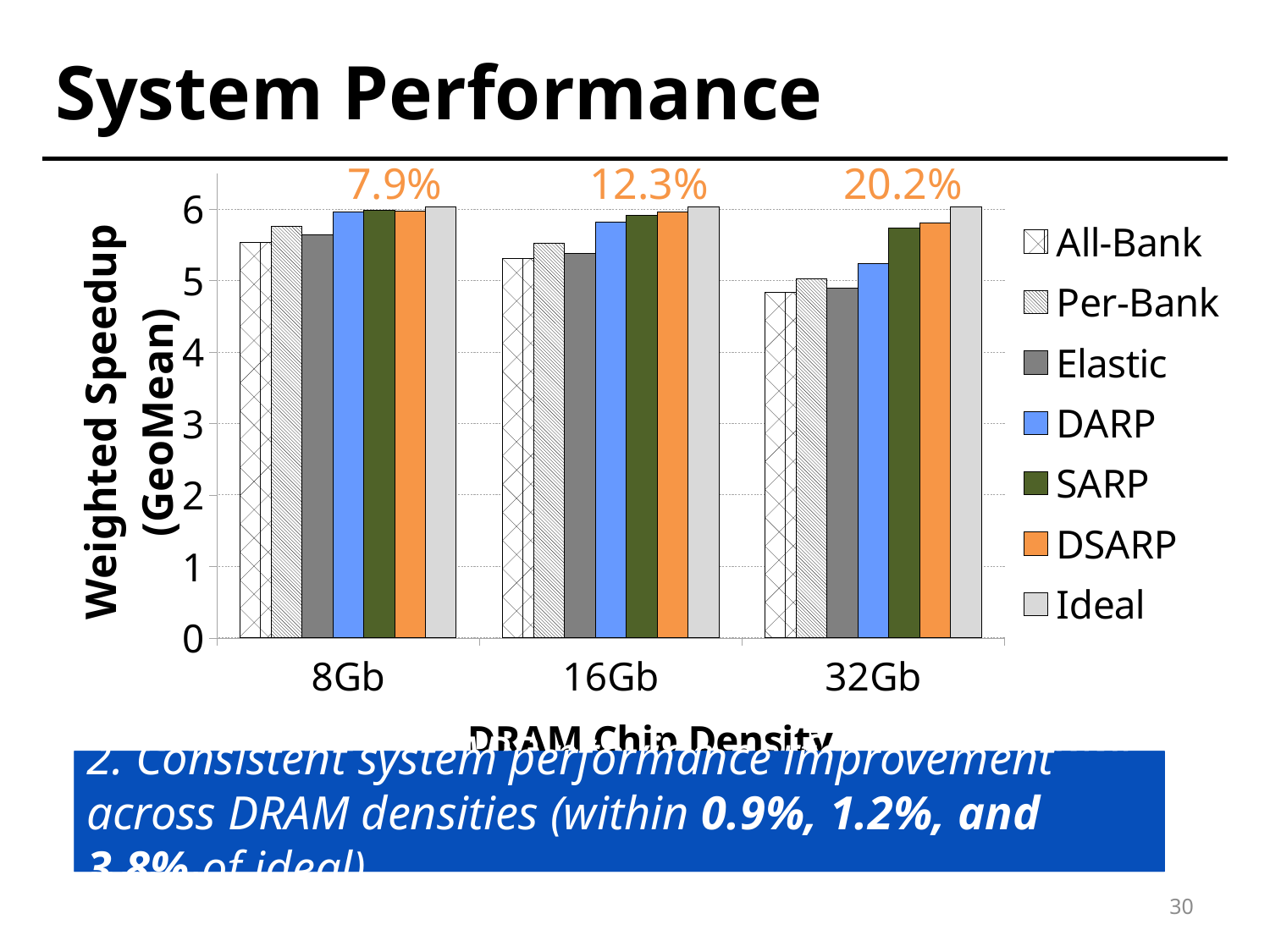
What kind of chart is shown on the slide? bar chart How many DRAM chip density categories are shown on the x axis? 3 Is the value for All-Bank at 8Gb greater or less than 5? greater Is the value for DARP at 32Gb greater or less than 5? greater Which is larger at 16Gb, DSARP or Elastic? DSARP What percentage is printed above the 16Gb group of bars? 12.3% Do the All-Bank values rise or fall as DRAM chip density increases from 8Gb to 32Gb? fall Which is larger at 32Gb, Ideal or All-Bank? Ideal What is the x-axis title of the chart? DRAM Chip Density How many series does the legend list? 7 Is the value for Per-Bank at 16Gb greater or less than 5? greater Which series has the highest value in the 32Gb group? Ideal